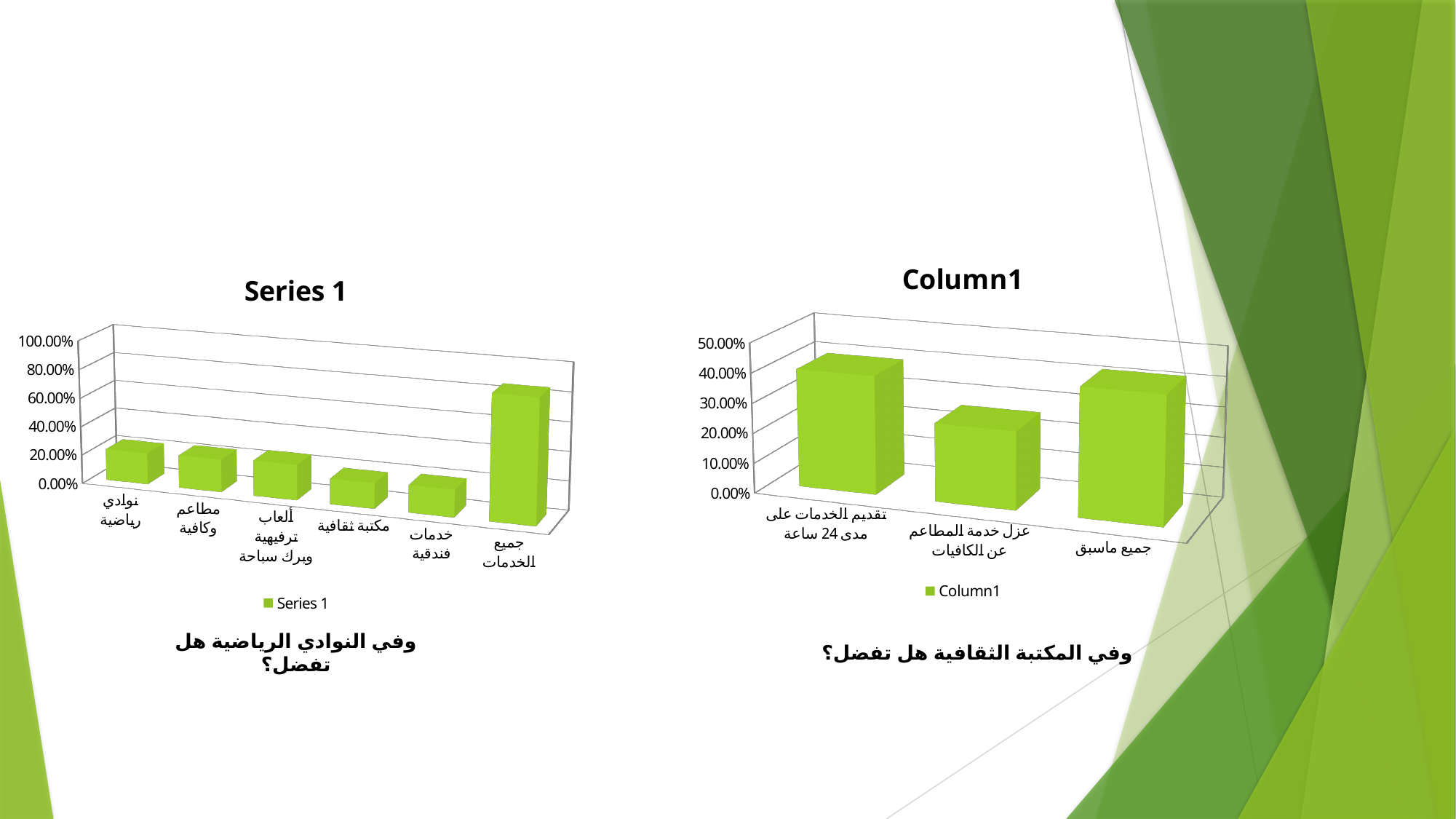
In the chart titled "Series 1", is the value for جميع الخدمات greater or less than 40.00%? greater In the chart titled "Column1", is the value for عزل خدمة المطاعم عن الكافيات greater or less than 40.00%? less In the chart titled "Column1", which is larger, the value for جميع ماسبق or the value for عزل خدمة المطاعم عن الكافيات? جميع ماسبق In the chart titled "Series 1", how many categories are shown on the x axis? 6 How many series does the legend of the chart titled "Column1" list? 1 In the chart titled "Series 1", which category has the highest value? جميع الخدمات What type of chart is the chart titled "Column1" on the right? bar chart In the chart titled "Column1", which category has the lowest value? عزل خدمة المطاعم عن الكافيات What type of chart is the chart titled "Series 1" on the left? bar chart In the chart titled "Column1", how many categories are shown on the x axis? 3 In the chart titled "Series 1", is the value for نوادي رياضية greater or less than 40.00%? less In the chart titled "Column1", which category has the highest value? جميع ماسبق